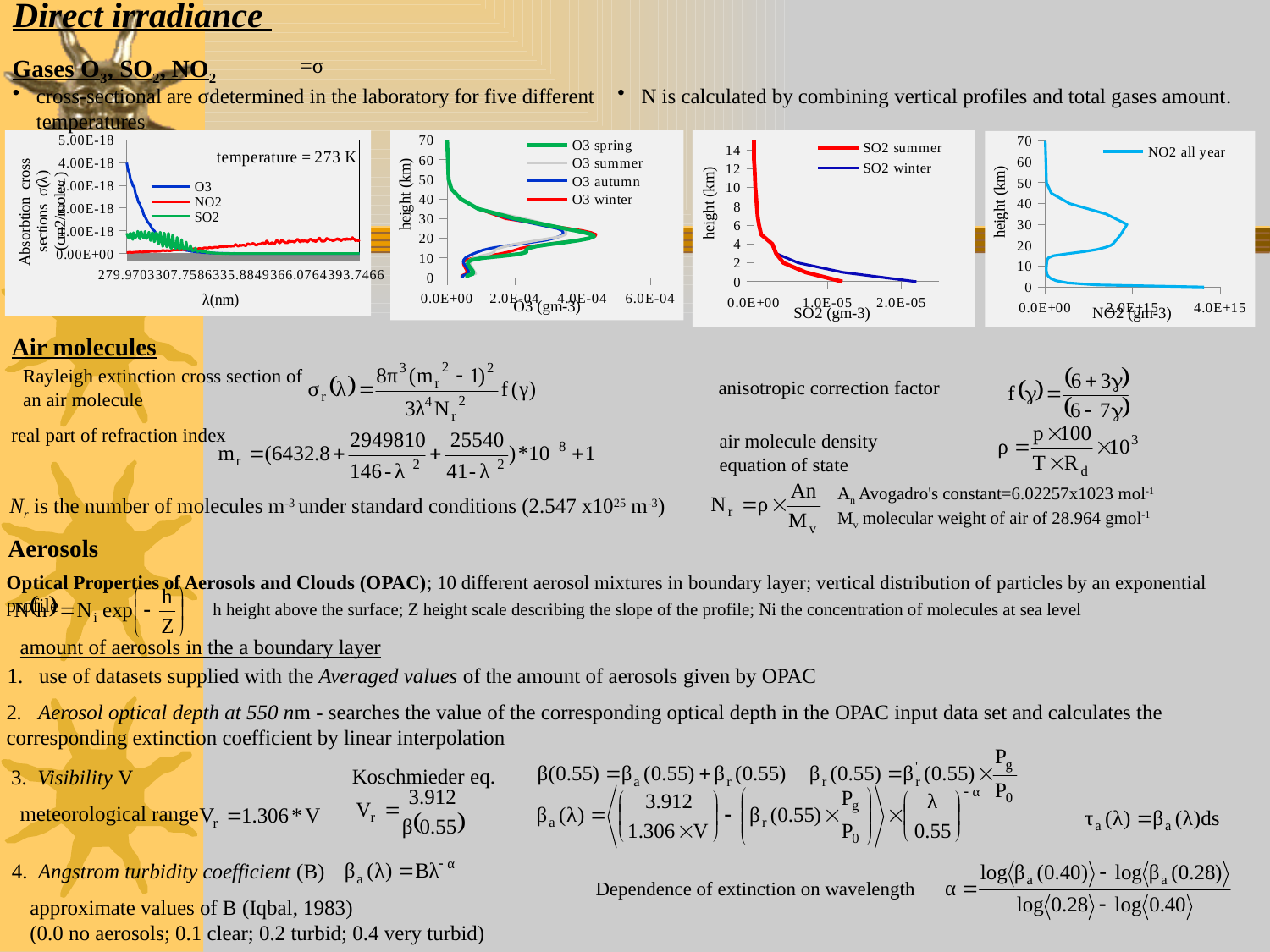
Which gases are listed in the legend of the leftmost absorption cross sections chart? O3, NO2, SO2 How many series does the legend of the NO2 (gm-3) vs height chart list? 1 How many series does the legend of the leftmost chart (absorption cross sections vs λ) list? 3 In the SO2 (gm-3) vs height chart, do the SO2 values rise or fall as height increases? fall How many series does the legend of the SO2 (gm-3) vs height chart list? 2 What is the highest tick on the height (km) axis of the O3 (gm-3) chart? 70 What temperature is annotated on the leftmost absorption cross sections chart? 273 K In the NO2 (gm-3) vs height chart, is the NO2 all year value at height 0 km greater or less than 2.0E+15? greater What kind of chart is the O3 (gm-3) vs height chart? line chart In the SO2 (gm-3) vs height chart, is the SO2 winter value at height 0 km greater or less than 1.0E-05? greater In the SO2 (gm-3) vs height chart, which series has the larger SO2 value at height 0 km, SO2 summer or SO2 winter? SO2 winter